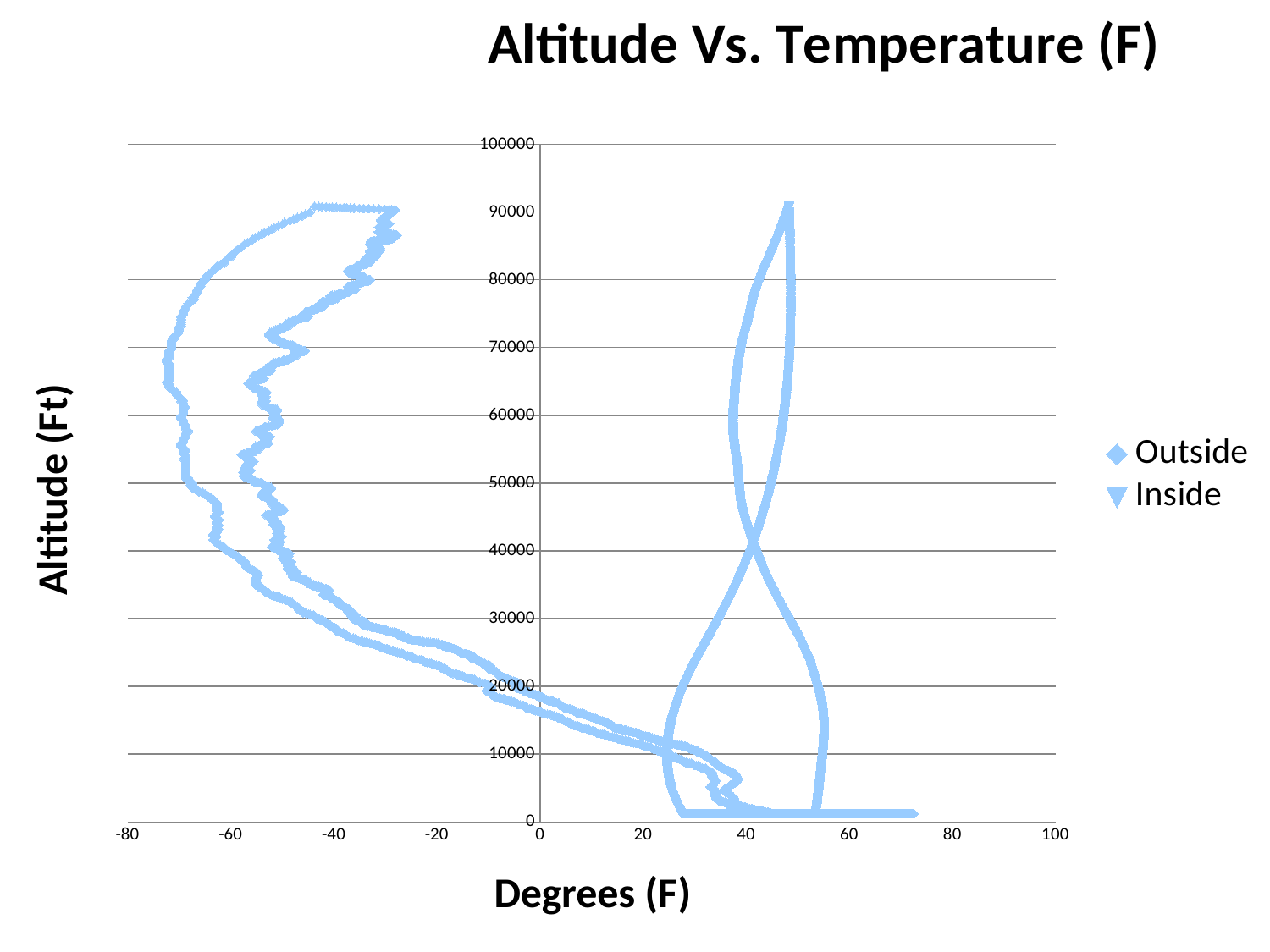
What kind of chart is shown on the slide? scatter chart What is the title of the chart? Altitude Vs. Temperature (F) What is the label of the vertical axis? Altitude (Ft) Is the Outside temperature at 70000 ft greater or less than -40? less Is the lowest Inside temperature on the chart greater or less than 20? greater Which series shows higher temperatures overall, Outside or Inside? Inside Is the Outside temperature at 50000 ft greater or less than -40? less How many series does the legend list? 2 Does the Outside temperature generally rise or fall as altitude increases from 0 to 50000 ft? fall